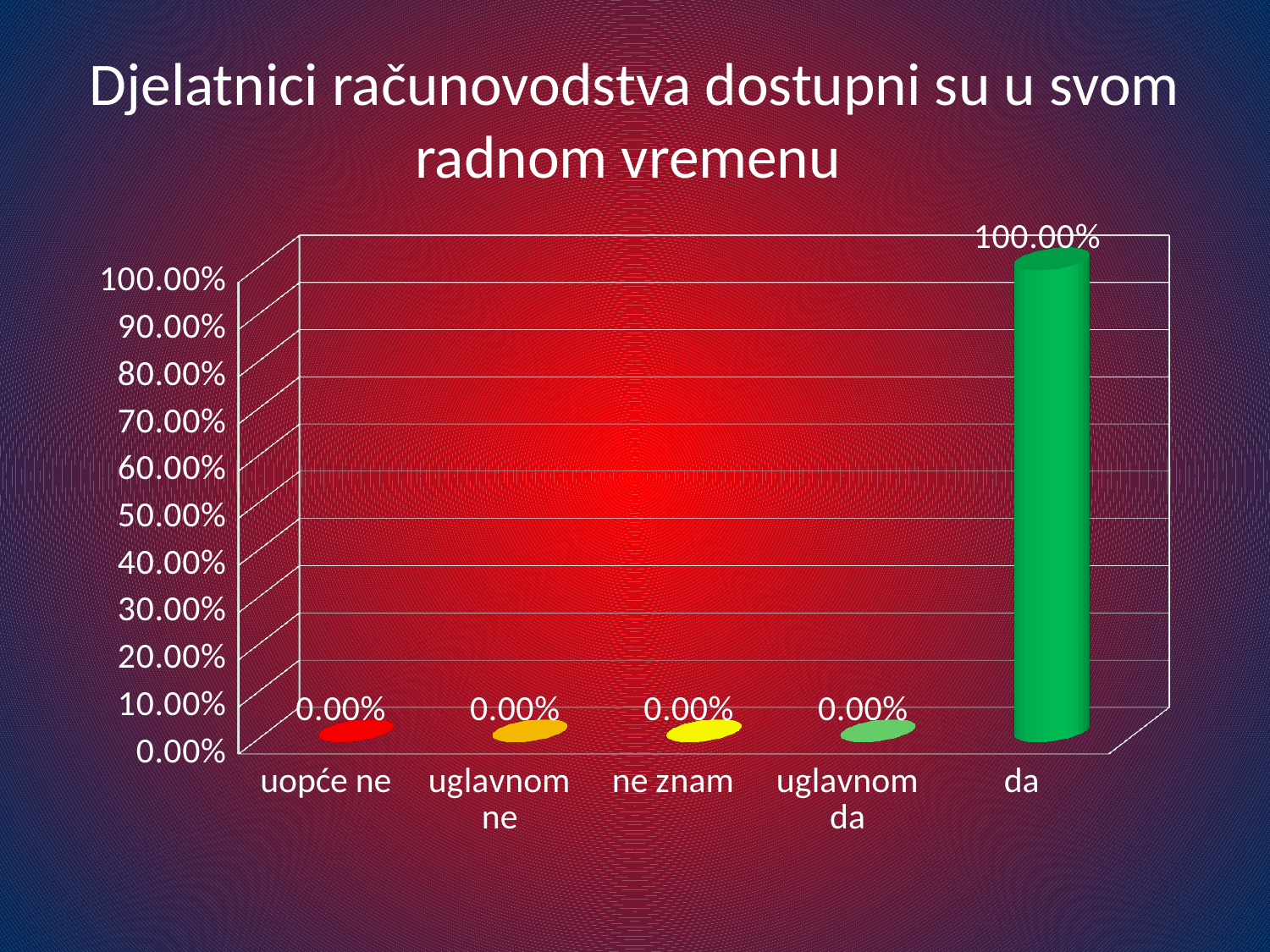
What is the difference between the values for "da" and "uglavnom da"? 100.00% Which category has the highest value? da What is the value for "da"? 100.00% What is the value for "ne znam"? 0.00% Is the value for "da" greater or less than 50.00%? greater What kind of chart is shown on the slide? bar chart What colour is the bar for "da"? green What is the value for "uglavnom da"? 0.00% How many categories are shown on the x axis? 5 Which is larger, the value for "da" or the value for "uglavnom ne"? da What is the title of the chart? Djelatnici računovodstva dostupni su u svom radnom vremenu What is the value for "uopće ne"? 0.00%